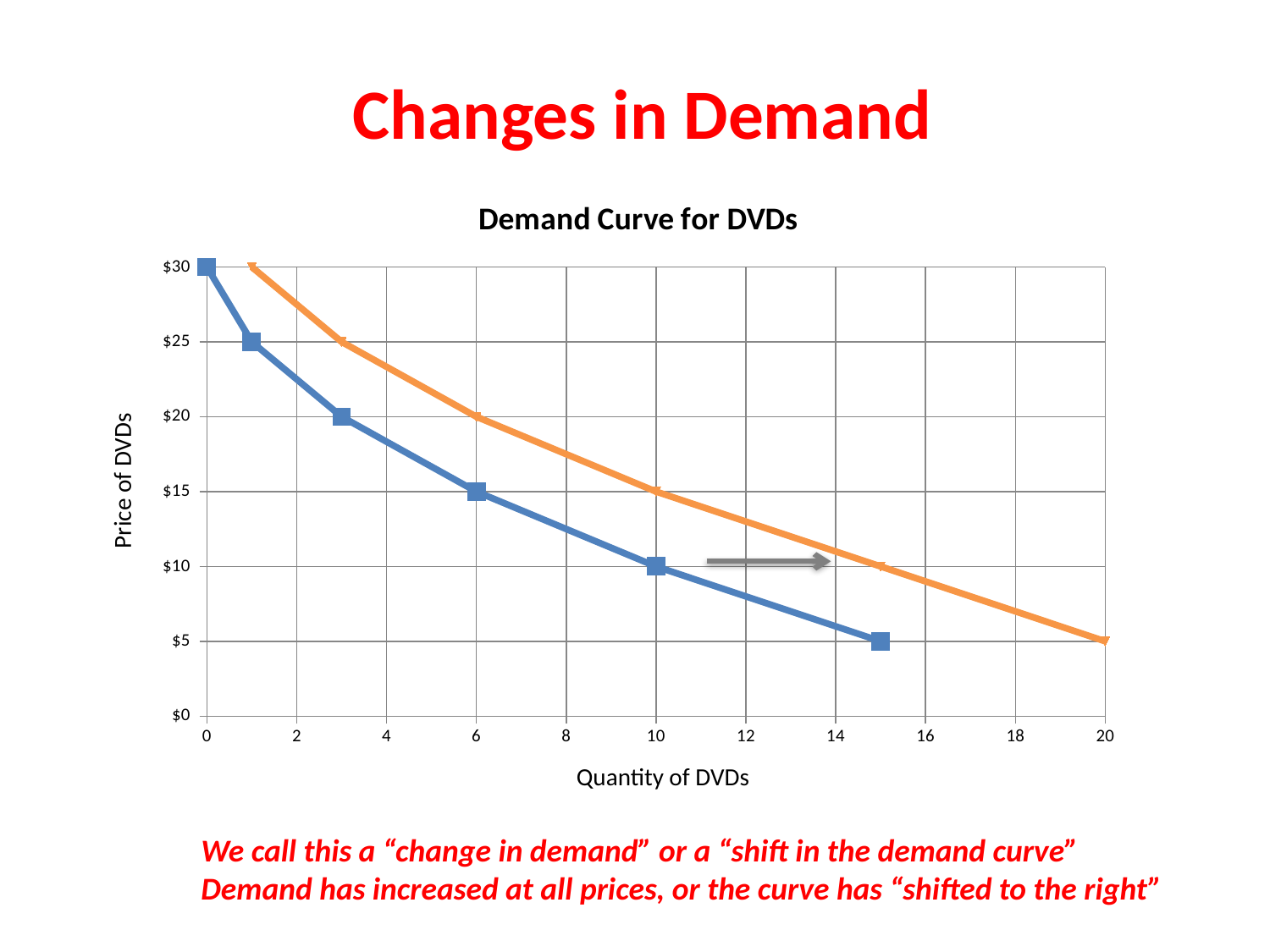
On the blue curve, what is the quantity of DVDs at a price of $10? 10 On the orange curve, what is the quantity of DVDs at a price of $5? 20 On the blue curve, is the quantity at a price of $25 greater or less than 2? less What kind of chart is shown on the slide? line chart On the blue curve, what is the quantity of DVDs at a price of $30? 0 What is the title of the chart? Demand Curve for DVDs On the blue curve, is the quantity at a price of $5 greater or less than 14? greater At a price of $15, which curve shows the larger quantity of DVDs, the blue or the orange? orange How many data points are plotted on the blue curve? 6 On the orange curve, what is the quantity of DVDs at a price of $20? 6 What is the label of the x axis? Quantity of DVDs As the quantity of DVDs increases along the x axis, does the price on each curve rise or fall? fall